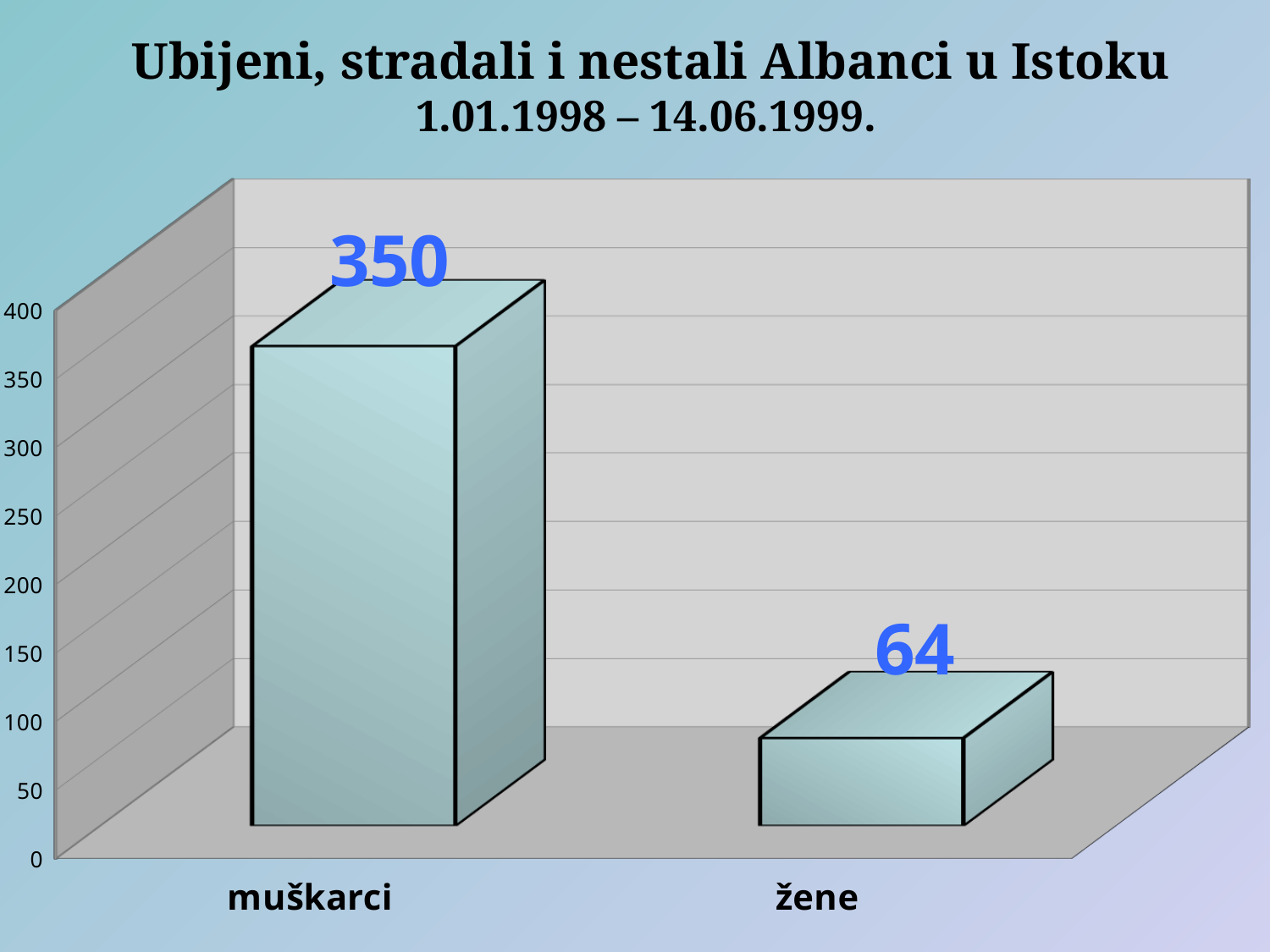
What kind of chart is shown on the slide? bar chart What is the title of the chart? Ubijeni, stradali i nestali Albanci u Istoku 1.01.1998 – 14.06.1999. Is the value for žene greater or less than 100? less How many categories are shown on the chart? 2 What is the value for muškarci? 350 What is the total of the two values shown on the chart? 414 What is the value for žene? 64 Which category has the highest value? muškarci Is the value for muškarci greater or less than 300? greater Which is larger, the value for muškarci or the value for žene? muškarci Which category has the lowest value? žene What is the difference between the values for muškarci and žene? 286